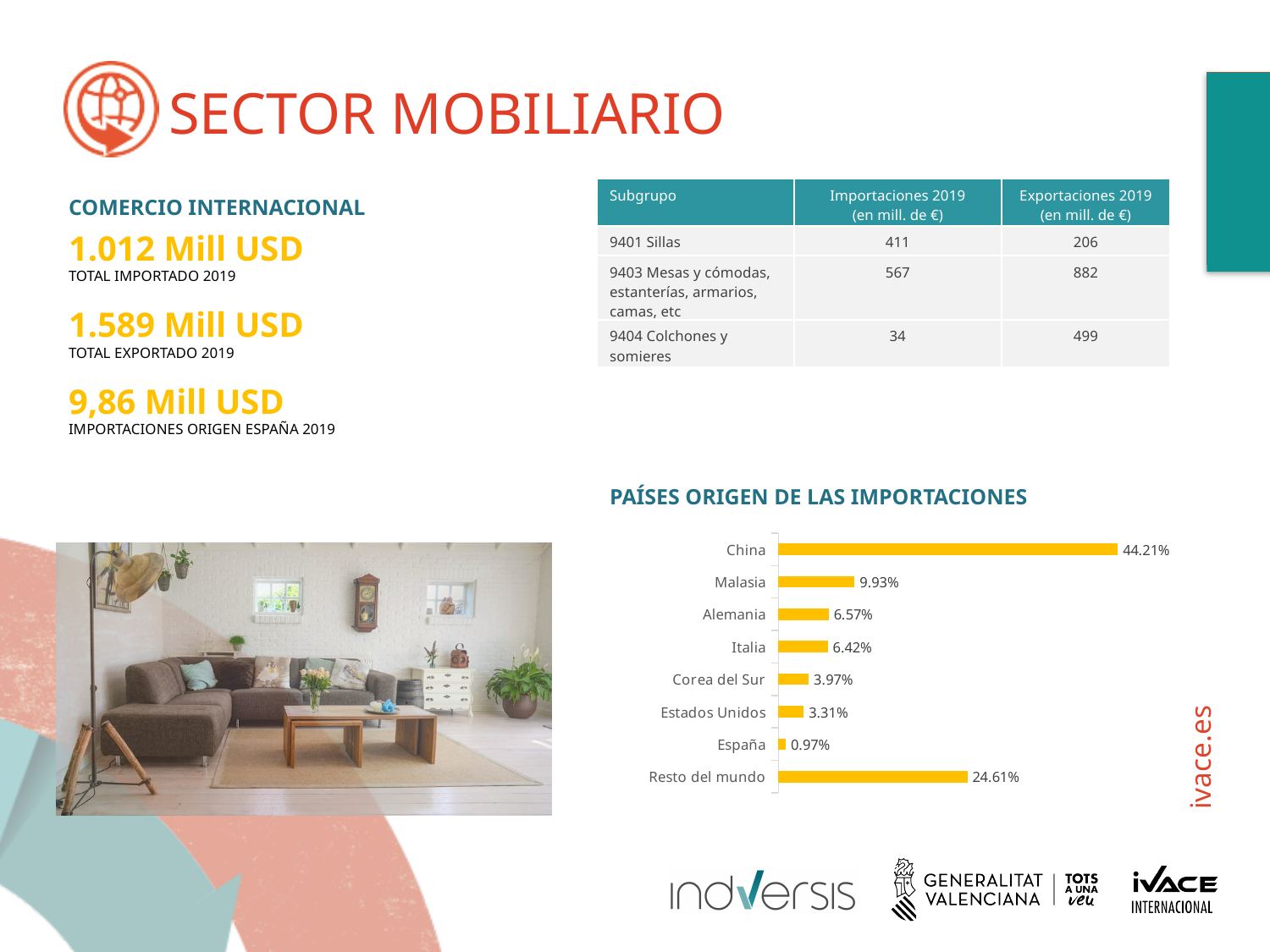
Which country has the highest share in the 'PAÍSES ORIGEN DE LAS IMPORTACIONES' chart? China What is the value for China in the 'PAÍSES ORIGEN DE LAS IMPORTACIONES' chart? 44.21% What is the difference between the values for Alemania and Italia in the 'PAÍSES ORIGEN DE LAS IMPORTACIONES' chart? 0.15% Which category has the lowest share in the 'PAÍSES ORIGEN DE LAS IMPORTACIONES' chart? España What is the value for Resto del mundo in the 'PAÍSES ORIGEN DE LAS IMPORTACIONES' chart? 24.61% What is the value for España in the 'PAÍSES ORIGEN DE LAS IMPORTACIONES' chart? 0.97% What is the difference between the values for China and Malasia in the 'PAÍSES ORIGEN DE LAS IMPORTACIONES' chart? 34.28% What colour are the bars in the 'PAÍSES ORIGEN DE LAS IMPORTACIONES' chart? Yellow What kind of chart is 'PAÍSES ORIGEN DE LAS IMPORTACIONES'? Bar chart Which is larger in the 'PAÍSES ORIGEN DE LAS IMPORTACIONES' chart, Corea del Sur or Estados Unidos? Corea del Sur What is the value for Malasia in the 'PAÍSES ORIGEN DE LAS IMPORTACIONES' chart? 9.93% How many categories are shown in the 'PAÍSES ORIGEN DE LAS IMPORTACIONES' chart? 8